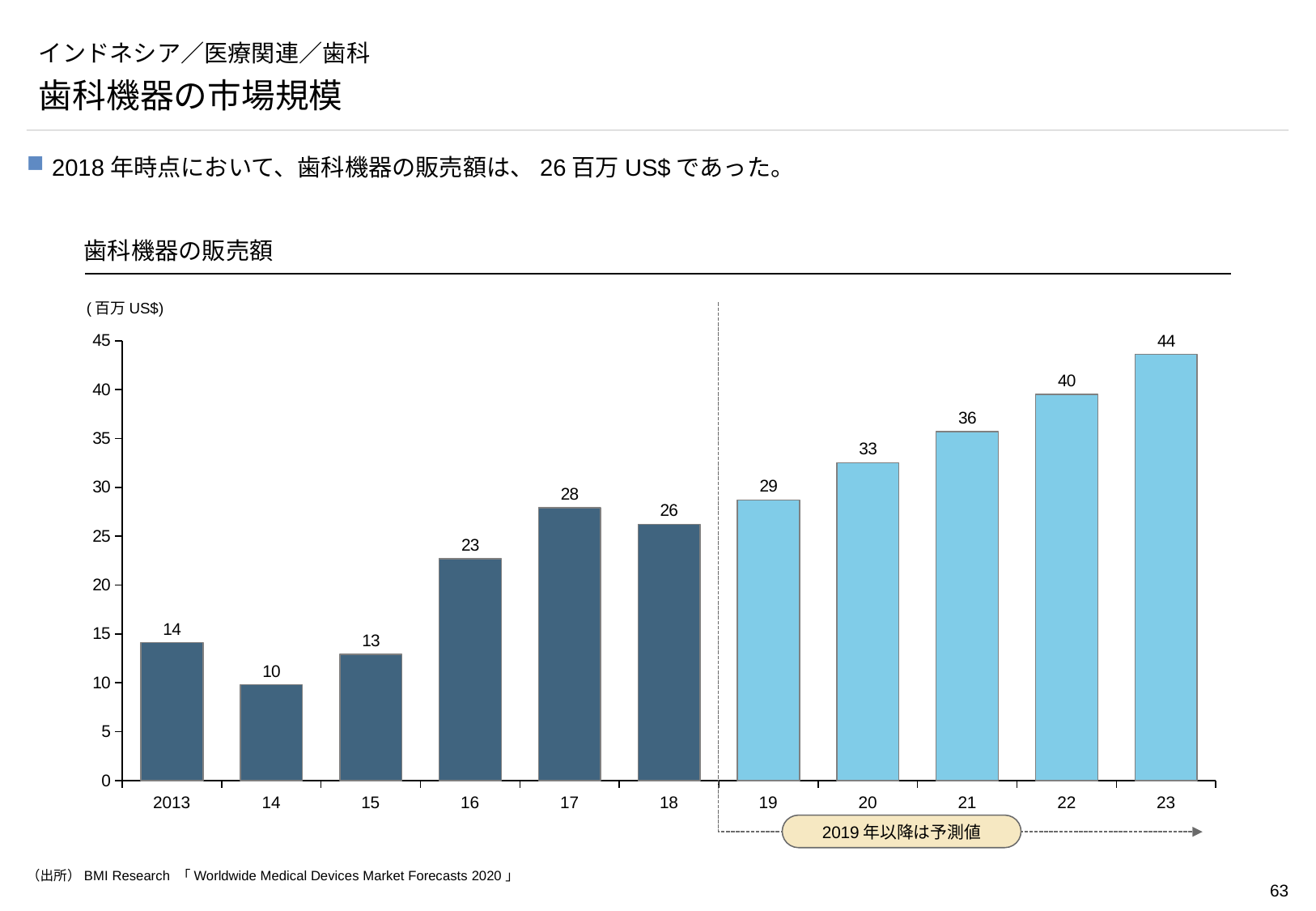
Which year has the lowest value in the chart? 14 (2014) Which year has the highest value in the chart? 23 (2023) Do the values generally rise or fall from 2018 to 2023? Rise What is the value for 2013 in the chart? 14 What is the value for 2018 in the 歯科機器の販売額 chart? 26 What is the difference between the values for 2023 and 2013? 30 How many years (bars) are shown in the chart? 11 What is the forecast value for 2023? 44 What unit is shown for the values in the chart? 百万 US$ Which is larger, the value for 2016 or the value for 2019? 2019 What is the difference between the values for 2017 and 2018? 2 What kind of chart is shown on the slide? Bar chart